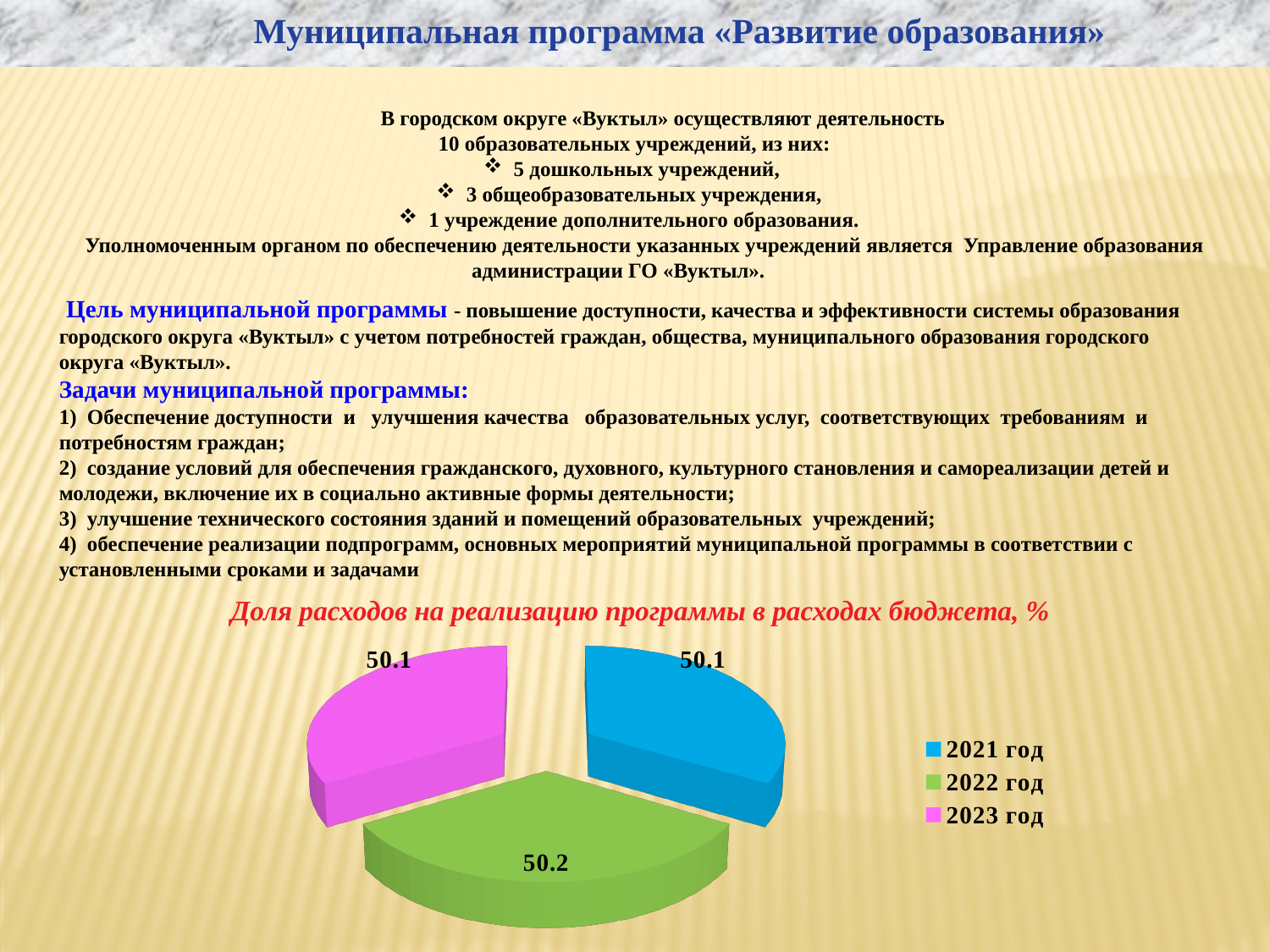
Which year has the highest value in the pie chart according to the data labels? 2022 год What is the value shown for 2022 год in the pie chart? 50.2 What is the difference between the values for 2022 год and 2021 год in the pie chart? 0.1 Which colour represents 2023 год in the pie chart? Pink What is the value shown for 2021 год in the pie chart? 50.1 What kind of chart is shown on the slide? Pie chart How many slices does the pie chart have? 3 How many entries does the legend of the pie chart list? 3 What is the value shown for 2023 год in the pie chart? 50.1 What is the title of the pie chart? Доля расходов на реализацию программы в расходах бюджета, % Which is larger in the pie chart, the value for 2022 год or the value for 2023 год? 2022 год